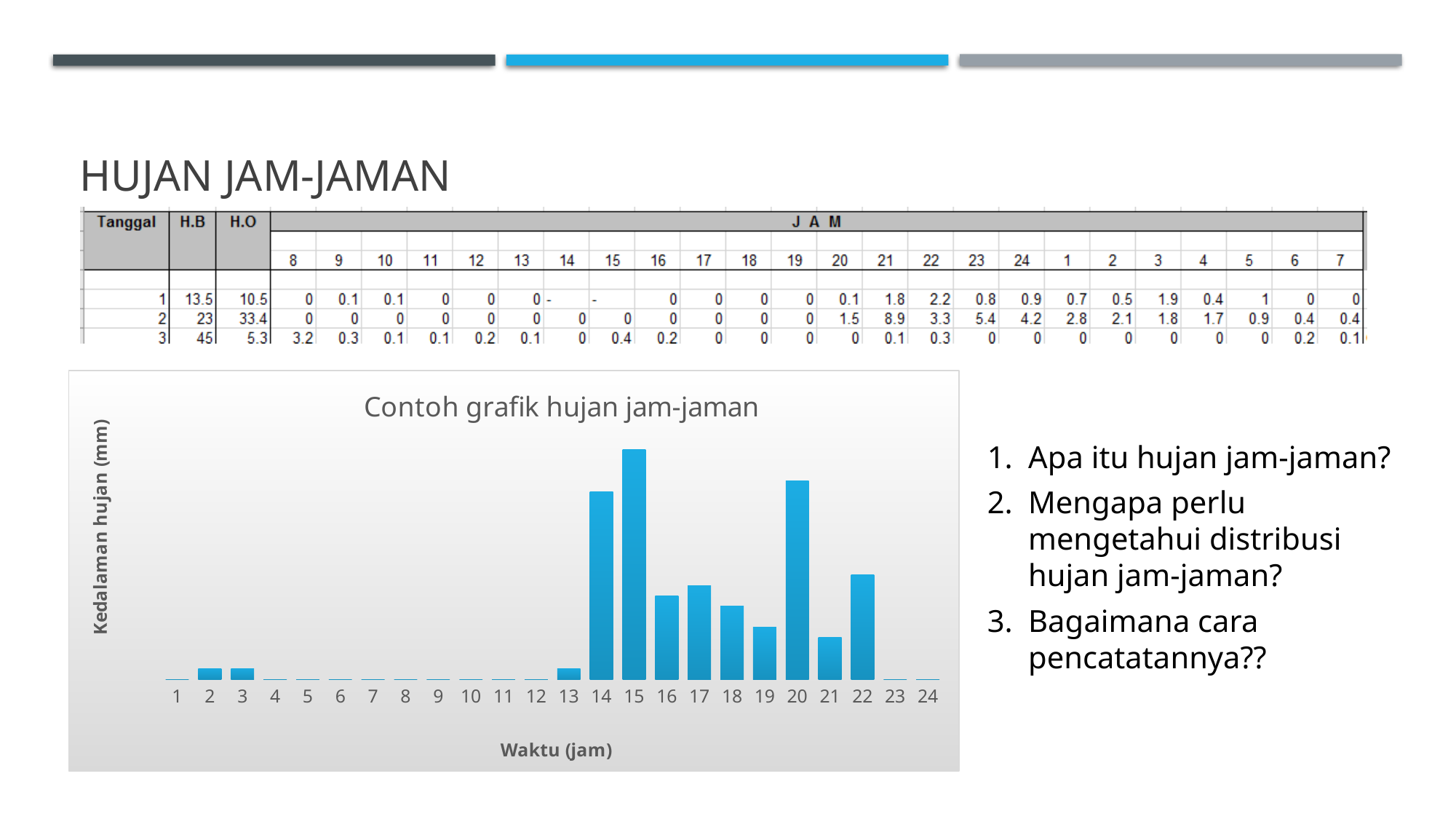
Which hour has the taller bar, 15 or 17? 15 Which hour has the taller bar, 2 or 14? 14 Do the bar heights rise or fall from hour 13 to hour 15? rise Do the bar heights rise or fall from hour 15 to hour 19? fall Which hour has the taller bar, 16 or 19? 16 What kind of chart is shown on the slide? bar chart What is the label of the x axis of the chart? Waktu (jam) Which hour has the highest bar in the chart? 15 What is the title of the chart? Contoh grafik hujan jam-jaman Among hours 14 through 22, which hour has the lowest bar? 21 How many hours (categories) are shown on the x axis of the chart? 24